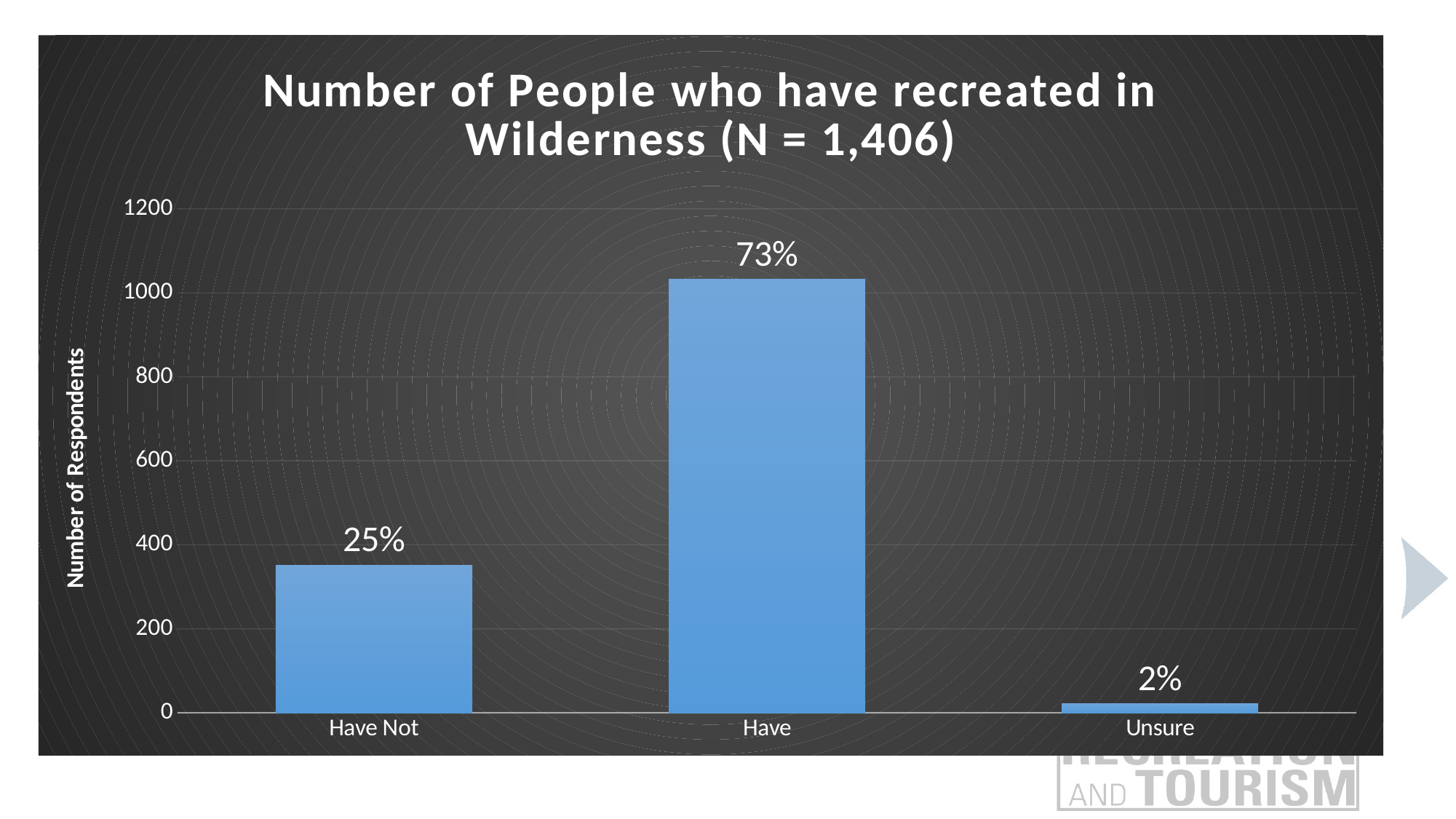
What is the title of the chart? Number of People who have recreated in Wilderness (N = 1,406) Which category has the lowest number of respondents? Unsure What is the label of the y axis? Number of Respondents What percentage label is shown on the 'Have' bar? 73% Is the number of respondents for 'Have Not' greater or less than 400? less How many categories are shown on the x axis? 3 Is the number of respondents for 'Have' greater or less than 1000? greater What percentage label is shown on the 'Unsure' bar? 2% What type of chart is shown on the slide? bar chart What percentage label is shown on the 'Have Not' bar? 25% Which is larger, the value for 'Have Not' or the value for 'Unsure'? Have Not Which category has the highest number of respondents? Have